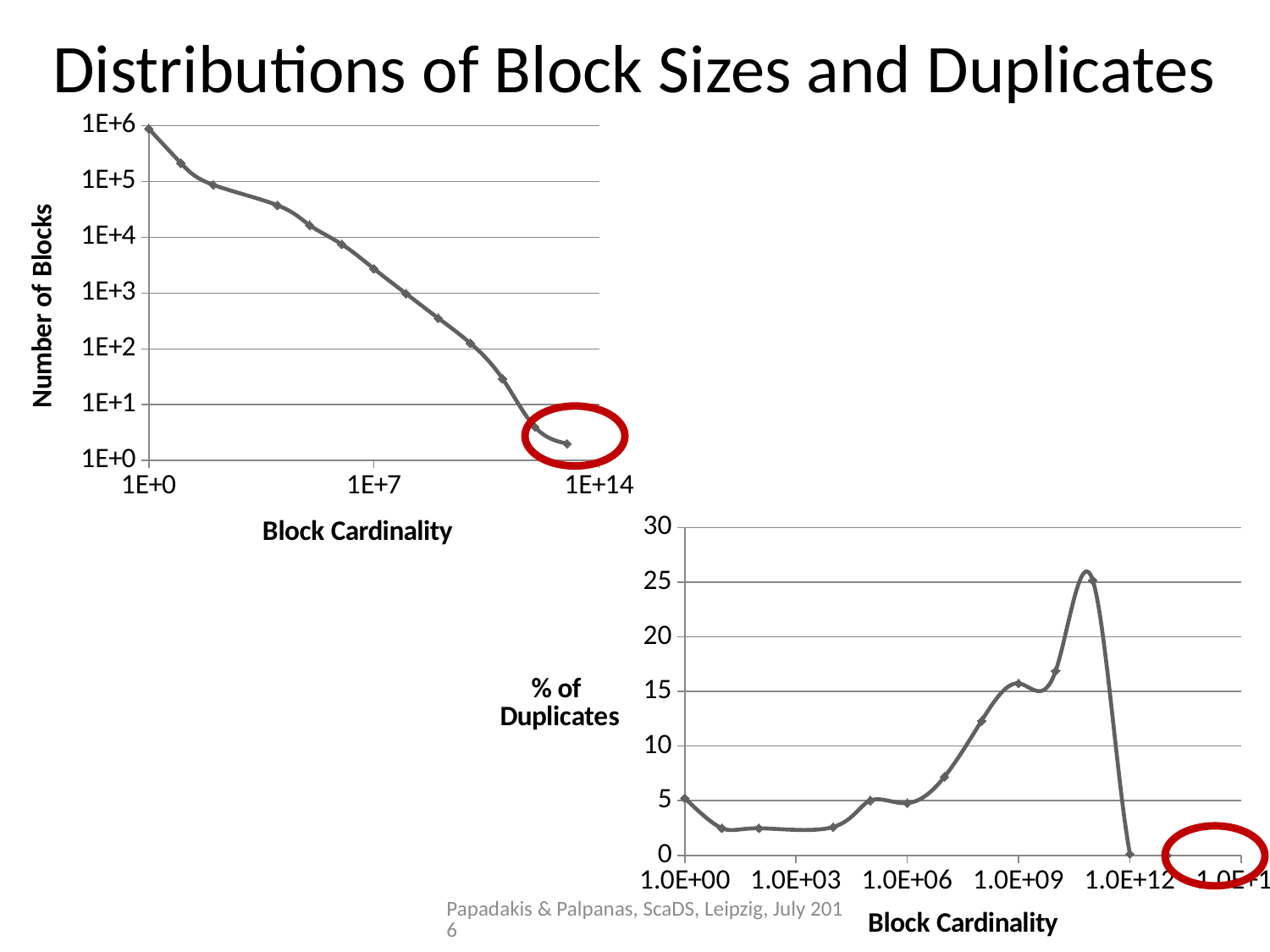
In the bottom-right chart, is the % of Duplicates at Block Cardinality 1.0E+00 greater or less than 10? less What is the y-axis label of the top-left chart? Number of Blocks In the top-left chart, is the Number of Blocks at Block Cardinality 1E+7 greater or less than 1E+4? less In the bottom-right chart, which has the larger % of Duplicates: Block Cardinality 1.0E+09 or 1.0E+00? 1.0E+09 In the bottom-right chart, is the highest % of Duplicates value greater or less than 30? less What is the x-axis label of the bottom-right chart? Block Cardinality What kind of chart is the top-left chart (Number of Blocks vs Block Cardinality)? line chart In the bottom-right chart, what is the % of Duplicates at the last plotted point (near Block Cardinality 1.0E+12)? 0 What kind of chart is the bottom-right chart (% of Duplicates vs Block Cardinality)? line chart In the top-left chart, do the values rise or fall as Block Cardinality increases along the x axis? fall